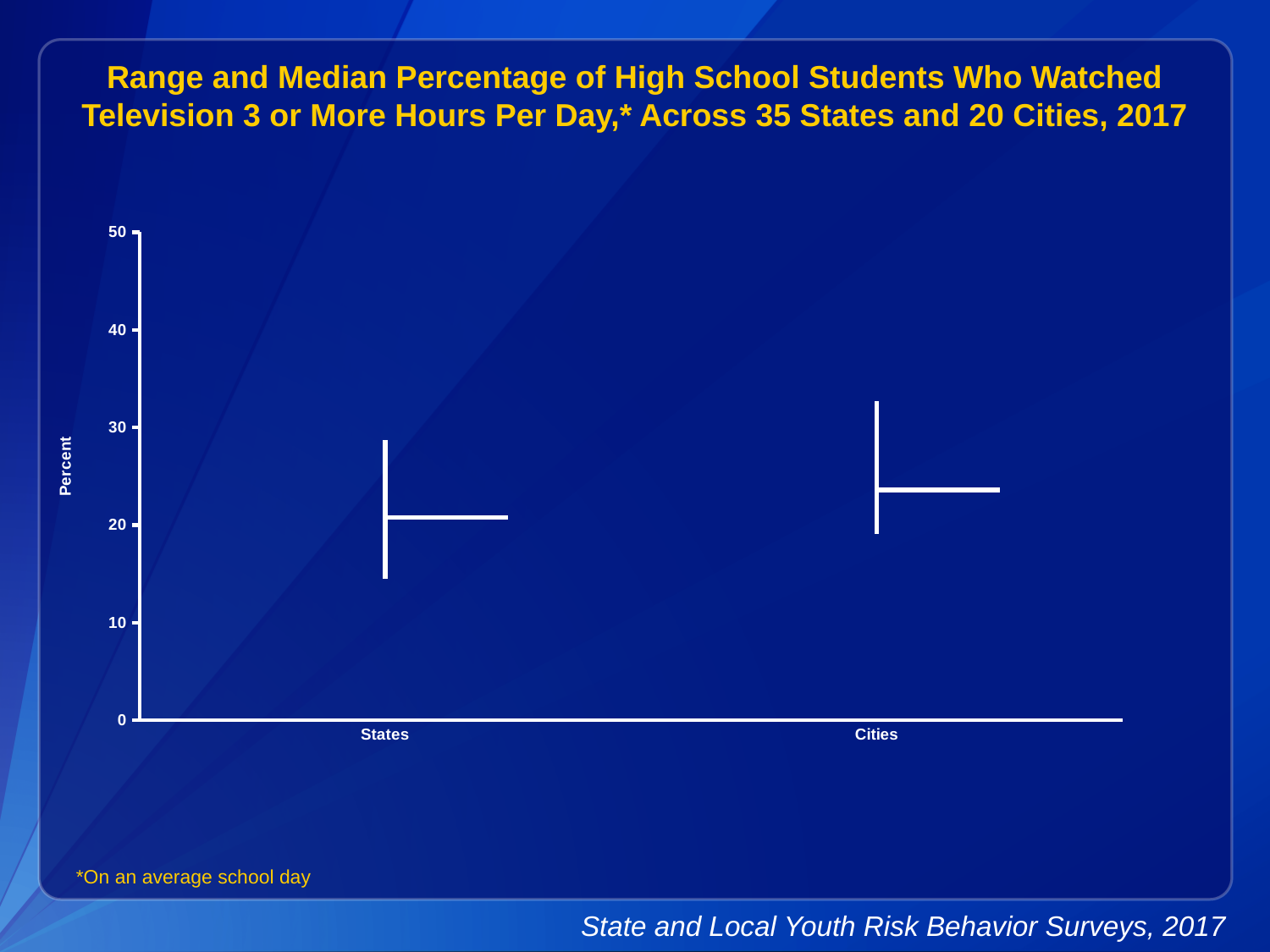
Is the median value for Cities greater or less than 30? less How many categories are shown on the x axis of the chart? 2 What is the label on the y axis of the chart? Percent Is the median value for States greater or less than 30? less What is the highest value shown on the y axis of the chart? 50 Is the top of the range for States greater or less than 30? less What are the two categories shown on the x axis? States and Cities Which category has the higher top of its range, States or Cities? Cities Which category has the higher median percentage, States or Cities? Cities